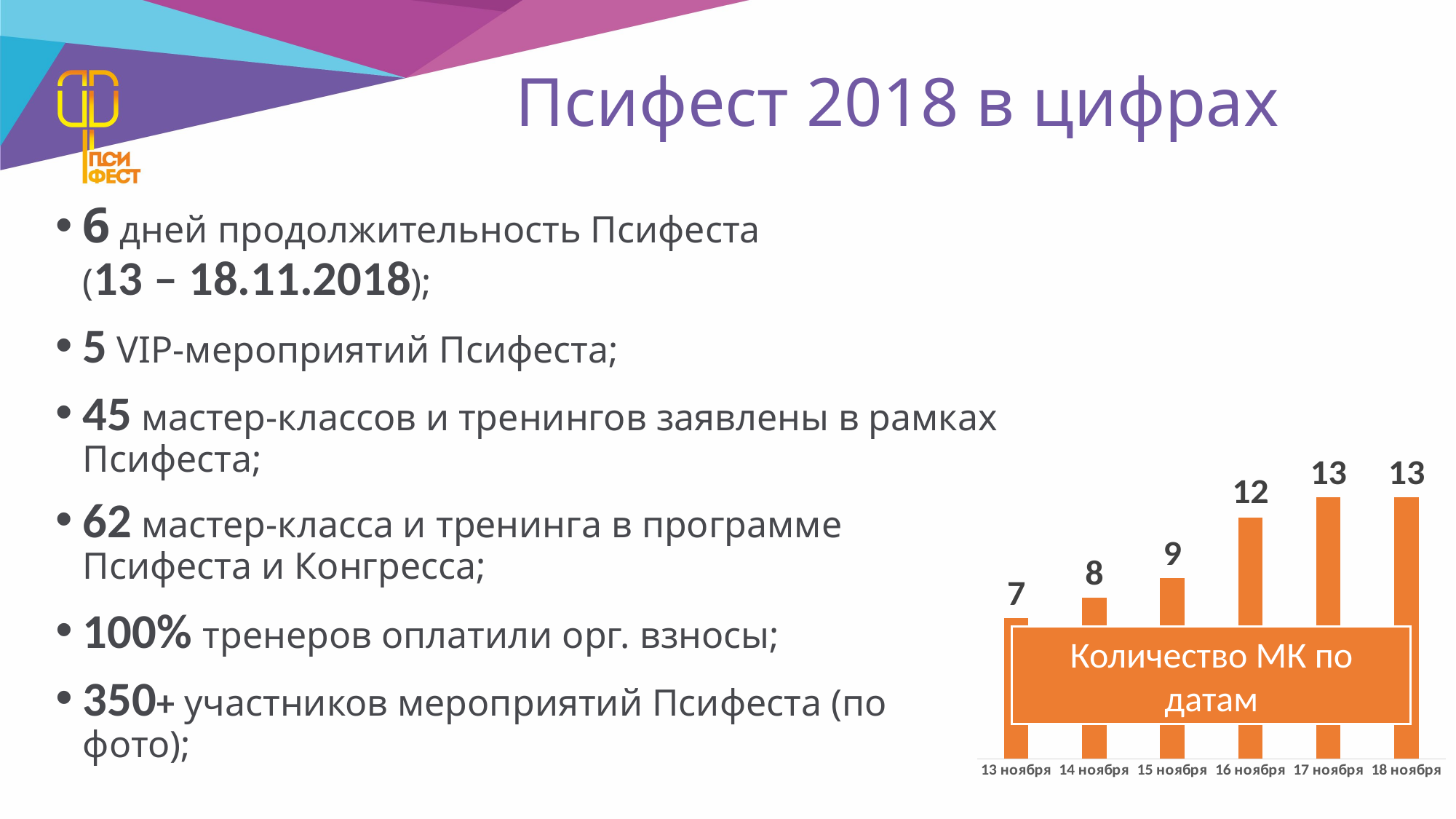
What is the highest value shown in the chart? 13 What is the value for 13 ноября in the chart? 7 What is the value for 15 ноября in the chart? 9 Do the values in the chart generally rise or fall from 13 ноября to 18 ноября? rise What is the title of the chart? Количество МК по датам Which is larger, the value for 15 ноября or the value for 16 ноября? 16 ноября What is the value for 16 ноября in the chart? 12 How many dates are shown on the x axis of the chart? 6 What is the difference between the values for 17 ноября and 14 ноября? 5 What is the difference between the values for 16 ноября and 13 ноября? 5 What kind of chart is shown on the slide? bar chart Which date has the lowest value in the chart? 13 ноября